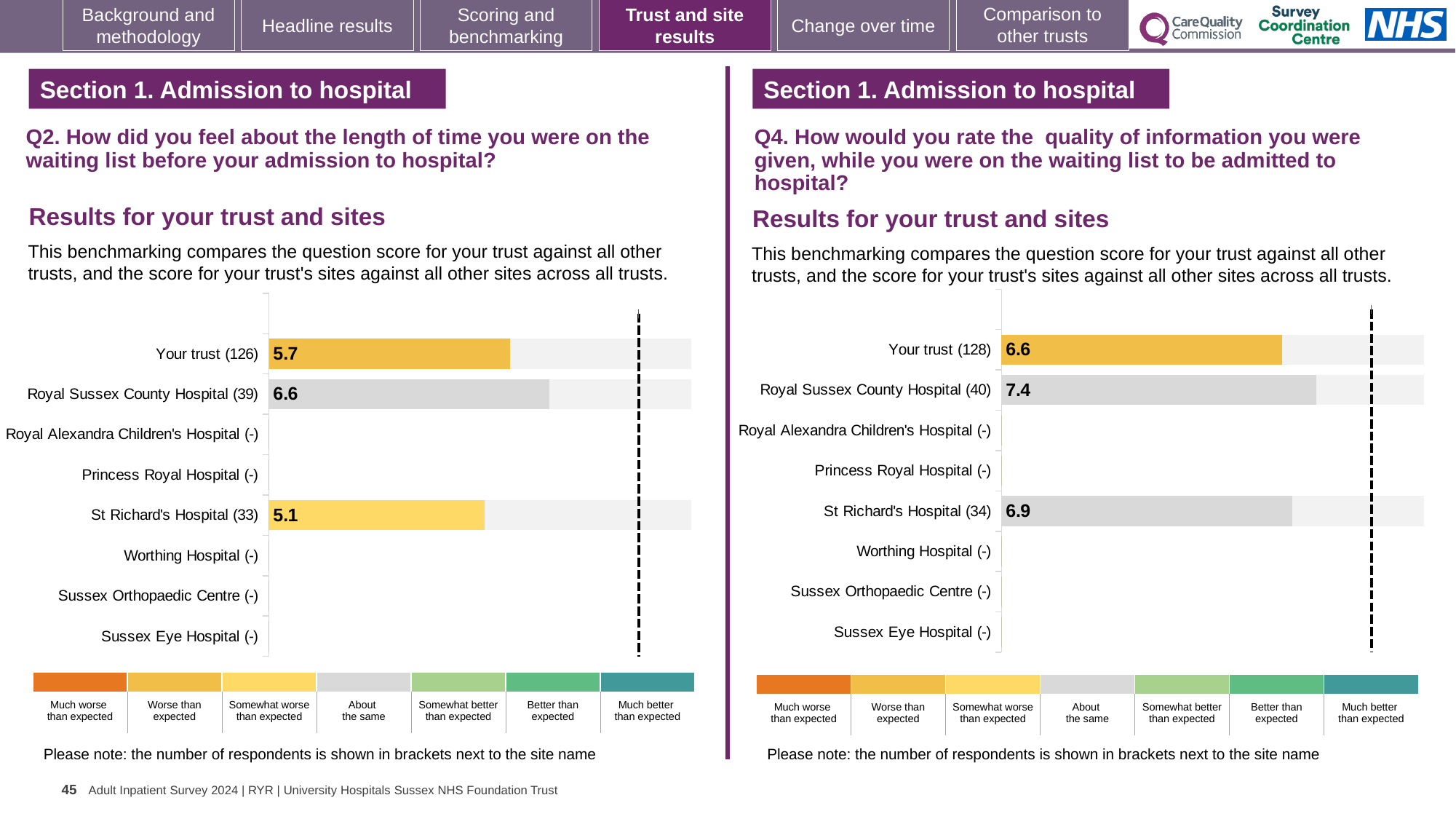
On the Q2 chart (left), what is the score for St Richard's Hospital (33)? 5.1 On the Q4 chart (right), what is the score for St Richard's Hospital (34)? 6.9 How many site or trust rows are listed on the Q2 chart (left)? 8 On the Q2 chart (left), what is the score for Your trust (126)? 5.7 On the Q2 chart (left), what is the difference between the scores for Royal Sussex County Hospital and St Richard's Hospital? 1.5 On the Q4 chart (right), which has the lower score, Your trust or St Richard's Hospital? Your trust What kind of chart is used on the Q4 chart (right)? Bar chart On the Q4 chart (right), what is the score for Your trust (128)? 6.6 On the Q4 chart (right), what is the score for Royal Sussex County Hospital (40)? 7.4 On the Q2 chart (left), which site or trust row has the highest score? Royal Sussex County Hospital (39) On the Q4 chart (right), what is the difference between the scores for Royal Sussex County Hospital and Your trust? 0.8 On the Q2 chart (left), what is the score for Royal Sussex County Hospital (39)? 6.6